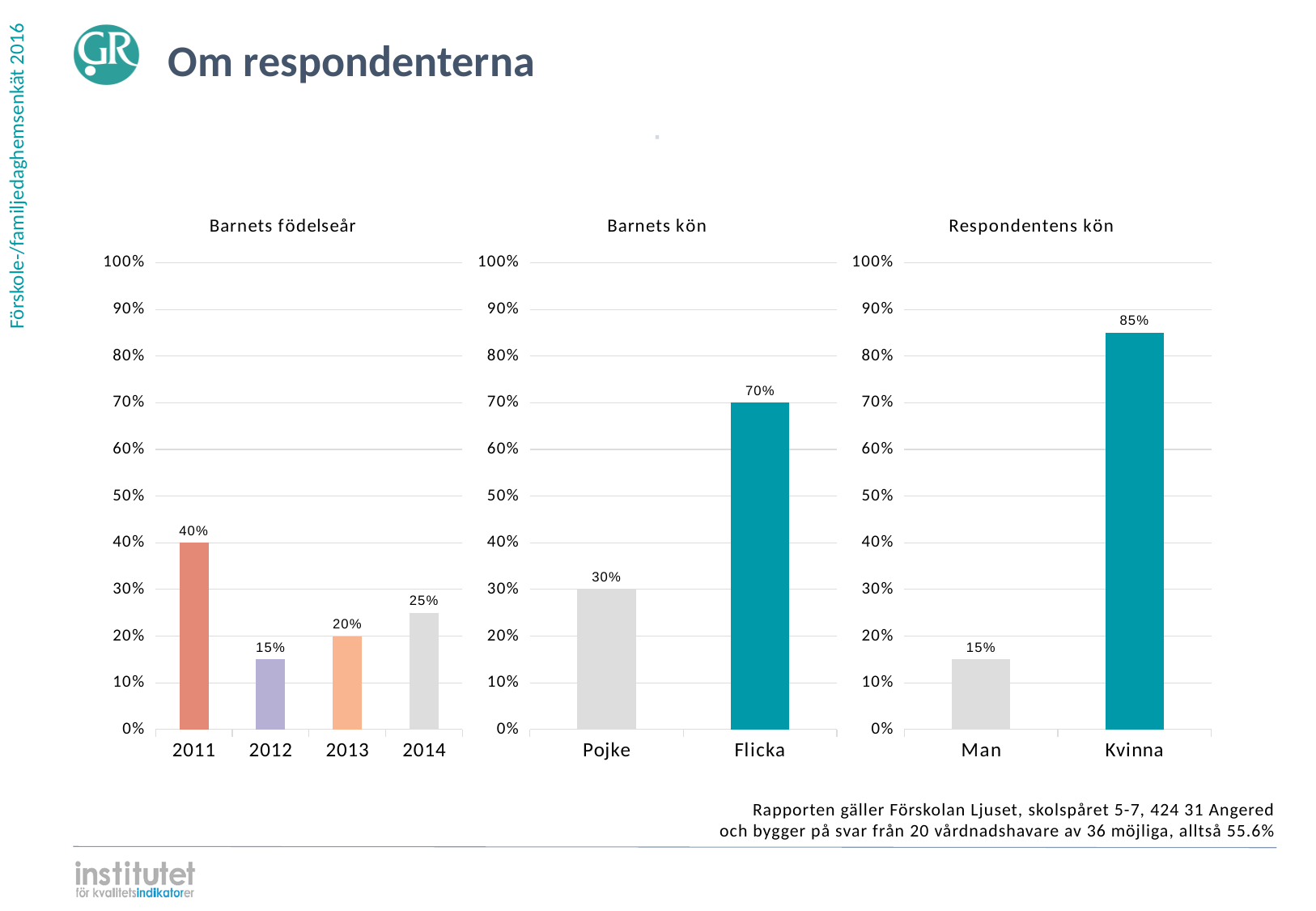
In the 'Barnets kön' chart, what is the difference between Flicka and Pojke? 40% In the 'Barnets kön' chart, what is the value for Pojke? 30% What kind of chart is the 'Respondentens kön' chart? Bar chart In the 'Barnets födelseår' chart, what is the value for 2011? 40% In the 'Barnets födelseår' chart, what is the difference between the values for 2014 and 2013? 5% In the 'Respondentens kön' chart, what is the value for Man? 15% In the 'Barnets födelseår' chart, how many years are shown on the x axis? 4 In the 'Barnets födelseår' chart, which year has the lowest value? 2012 In the 'Respondentens kön' chart, what is the value for Kvinna? 85% In the 'Barnets födelseår' chart, which year has the highest value? 2011 How many charts are shown on the slide? 3 In the 'Barnets kön' chart, which category is larger, Pojke or Flicka? Flicka